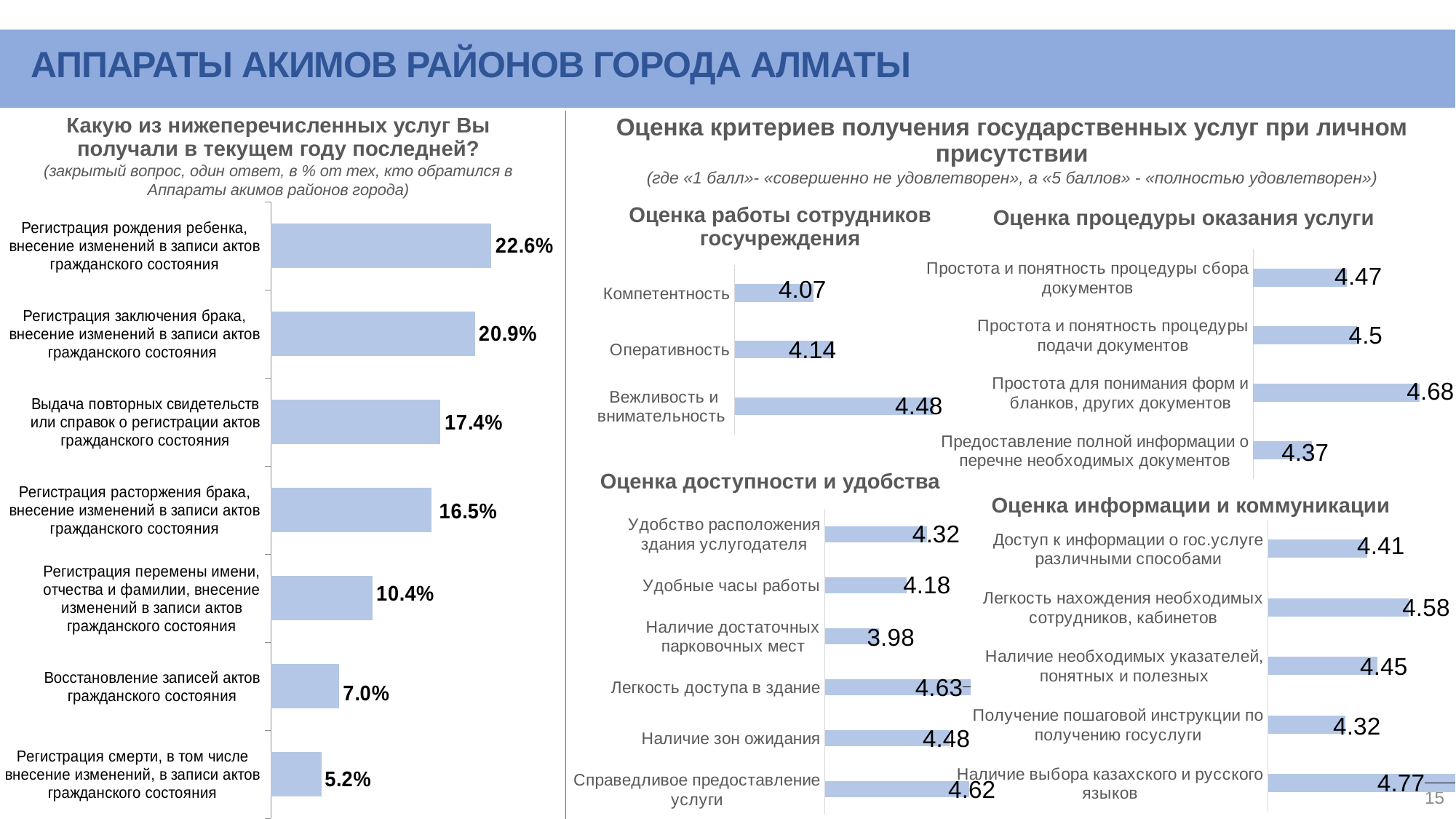
In the chart 'Какую из нижеперечисленных услуг Вы получали в текущем году последней?', what is the difference between the values for 'Регистрация рождения ребенка...' and 'Восстановление записей актов гражданского состояния'? 15.6% In the chart 'Какую из нижеперечисленных услуг Вы получали в текущем году последней?', what is the value for 'Регистрация заключения брака, внесение изменений в записи актов гражданского состояния'? 20.9% In the chart 'Оценка процедуры оказания услуги', what is the value for 'Простота для понимания форм и бланков, других документов'? 4.68 What type of chart is 'Оценка информации и коммуникации'? Bar chart In the chart 'Оценка доступности и удобства', what is the value for 'Наличие достаточных парковочных мест'? 3.98 In the chart 'Оценка процедуры оказания услуги', which category has the lowest value? Предоставление полной информации о перечне необходимых документов In the chart 'Оценка доступности и удобства', which is larger: 'Удобные часы работы' or 'Наличие зон ожидания'? Наличие зон ожидания How many categories are shown in the chart 'Какую из нижеперечисленных услуг Вы получали в текущем году последней?'? 7 In the chart 'Оценка работы сотрудников госучреждения', what is the value for 'Оперативность'? 4.14 In the chart 'Оценка работы сотрудников госучреждения', which category has the highest value? Вежливость и внимательность In the chart 'Какую из нижеперечисленных услуг Вы получали в текущем году последней?', which category has the lowest value? Регистрация смерти, в том числе внесение изменений, в записи актов гражданского состояния In the chart 'Оценка информации и коммуникации', which category has the highest value? Наличие выбора казахского и русского языков